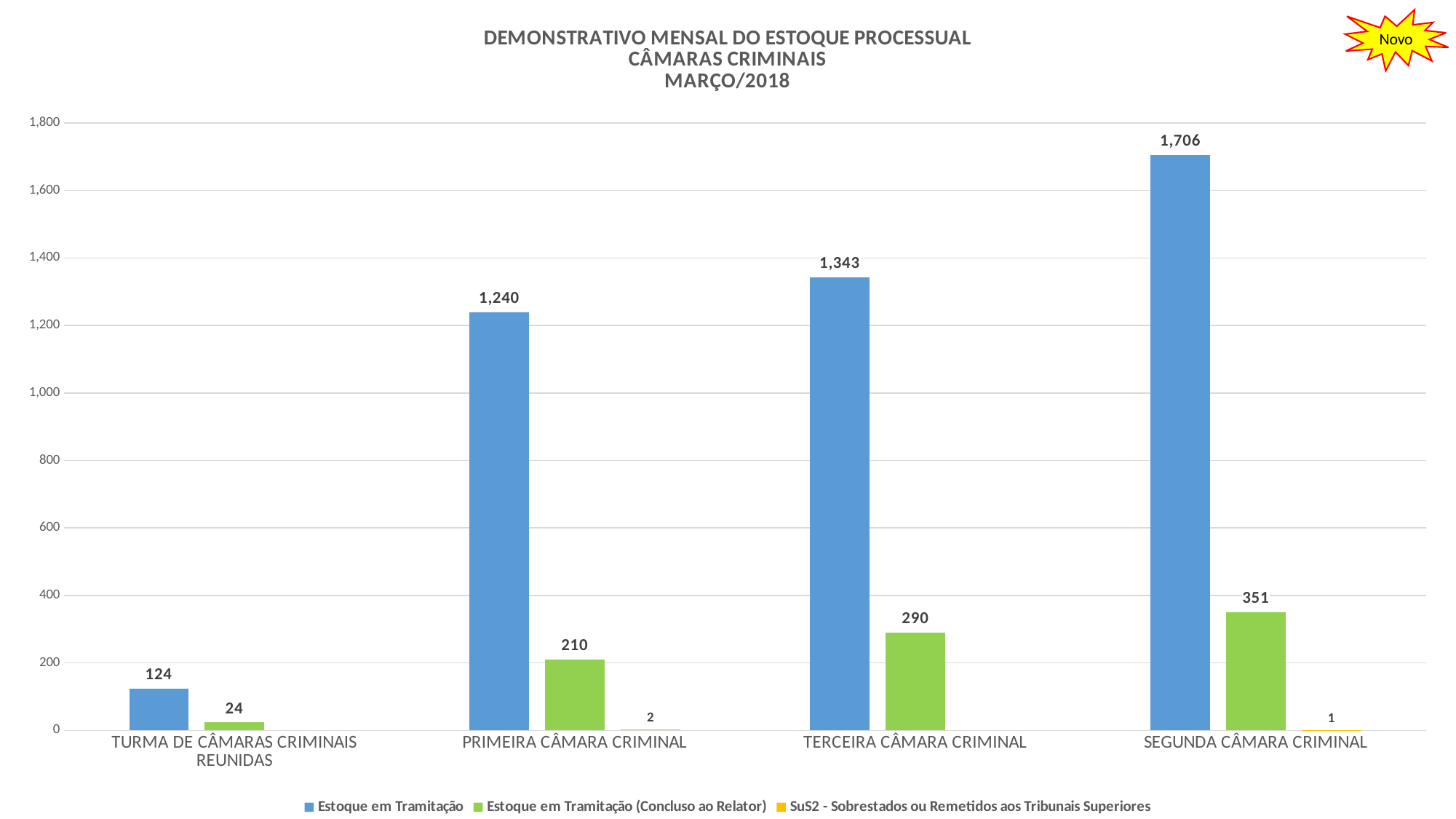
How many categories are shown on the x axis? 4 Is the Estoque em Tramitação value for PRIMEIRA CÂMARA CRIMINAL greater or less than 1,200? greater What is the value of SuS2 - Sobrestados ou Remetidos aos Tribunais Superiores for PRIMEIRA CÂMARA CRIMINAL? 2 Which category has the lowest value for Estoque em Tramitação (Concluso ao Relator)? TURMA DE CÂMARAS CRIMINAIS REUNIDAS What is the value of Estoque em Tramitação for SEGUNDA CÂMARA CRIMINAL? 1,706 Which is larger: Estoque em Tramitação (Concluso ao Relator) for PRIMEIRA CÂMARA CRIMINAL or for SEGUNDA CÂMARA CRIMINAL? SEGUNDA CÂMARA CRIMINAL What is the value of Estoque em Tramitação (Concluso ao Relator) for TERCEIRA CÂMARA CRIMINAL? 290 Which category has the highest value for Estoque em Tramitação? SEGUNDA CÂMARA CRIMINAL What is the difference between the Estoque em Tramitação values for SEGUNDA CÂMARA CRIMINAL and TERCEIRA CÂMARA CRIMINAL? 363 What is the value of Estoque em Tramitação for TURMA DE CÂMARAS CRIMINAIS REUNIDAS? 124 How many series does the legend list? 3 What kind of chart is shown on the slide? Bar chart